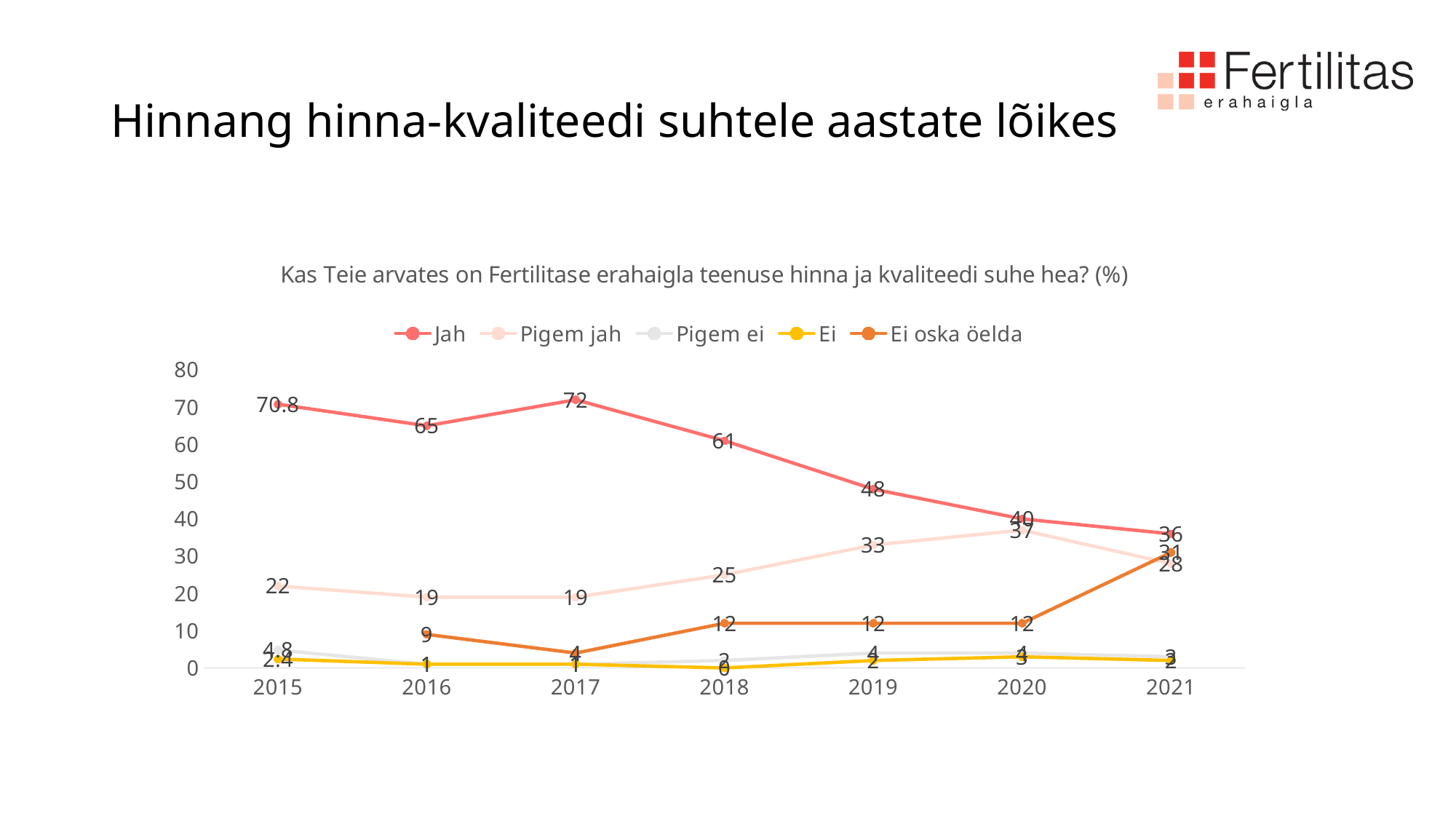
What is the value for Pigem jah in 2020? 37 What is the value for Jah in 2017? 72 In which year is the Jah series highest? 2017 How many years are shown on the x axis? 7 What is the value for Ei oska öelda in 2016? 9 What is the value for Jah in 2015? 70.8 What is the value for Ei oska öelda in 2021? 31 In 2021, which is larger: Jah or Pigem jah? Jah What kind of chart is shown on the slide? Line chart How many series does the legend list? 5 In which year is the Jah series lowest? 2021 What is the difference between the Jah value in 2017 and in 2021? 36